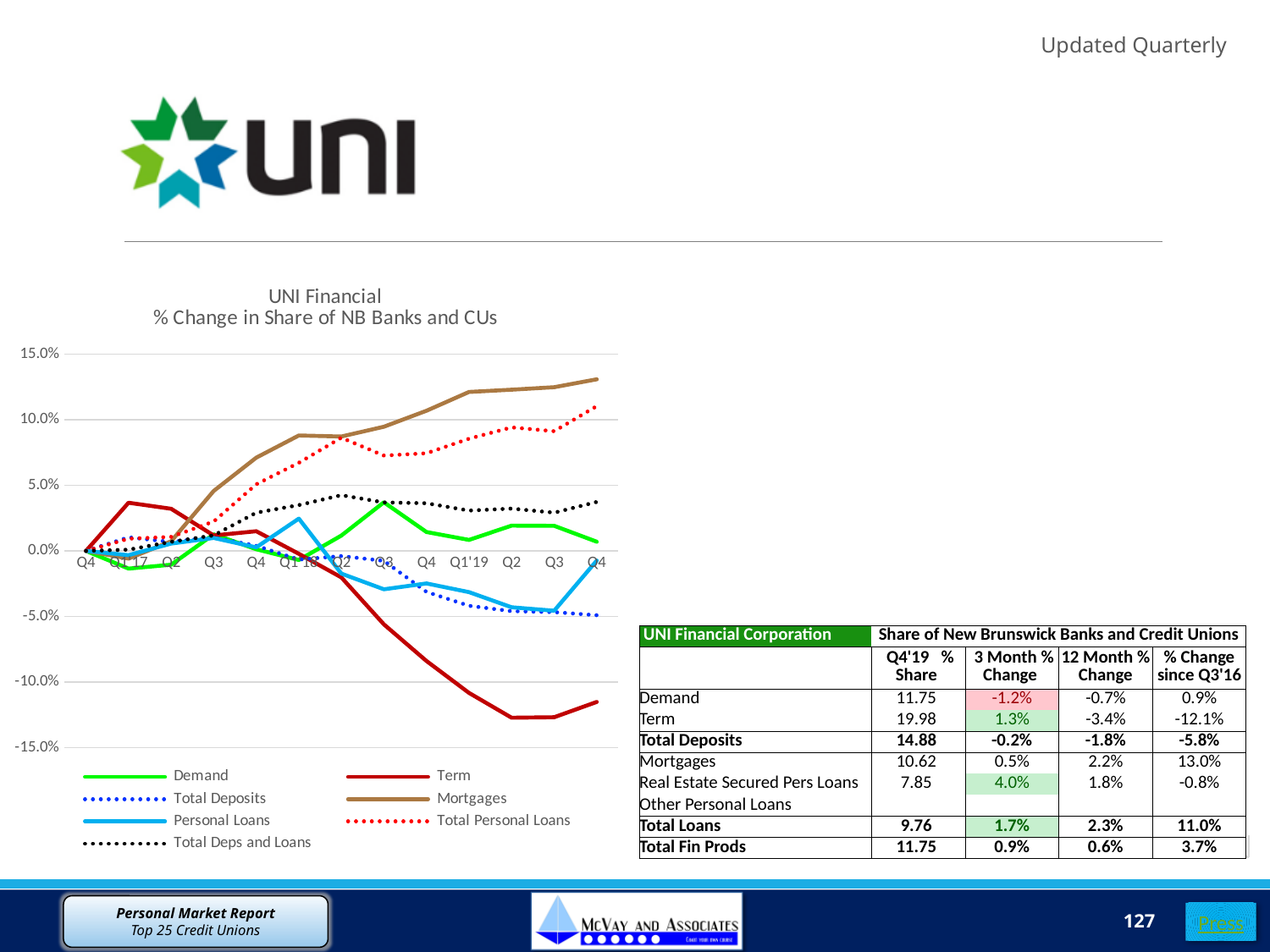
What is the title of the chart? UNI Financial % Change in Share of NB Banks and CUs What kind of chart is shown on the slide? line chart How many quarters are plotted along the x axis of the chart? 13 Is the value for Term at Q2 of 2019 greater or less than -10.0%? less Is the value for Total Personal Loans at the final Q4 greater or less than 5.0%? greater Which series has the highest value at the final quarter (Q4 on the right) of the chart? Mortgages Does the Mortgages series generally rise or fall from the first quarter to the last quarter on the chart? rise Is the value for Mortgages at the final Q4 greater or less than 10.0%? greater Which series has the lowest value at the final quarter (Q4 on the right) of the chart? Term At the final Q4, which is larger: the value for Mortgages or the value for Term? Mortgages How many series does the chart legend list? 7